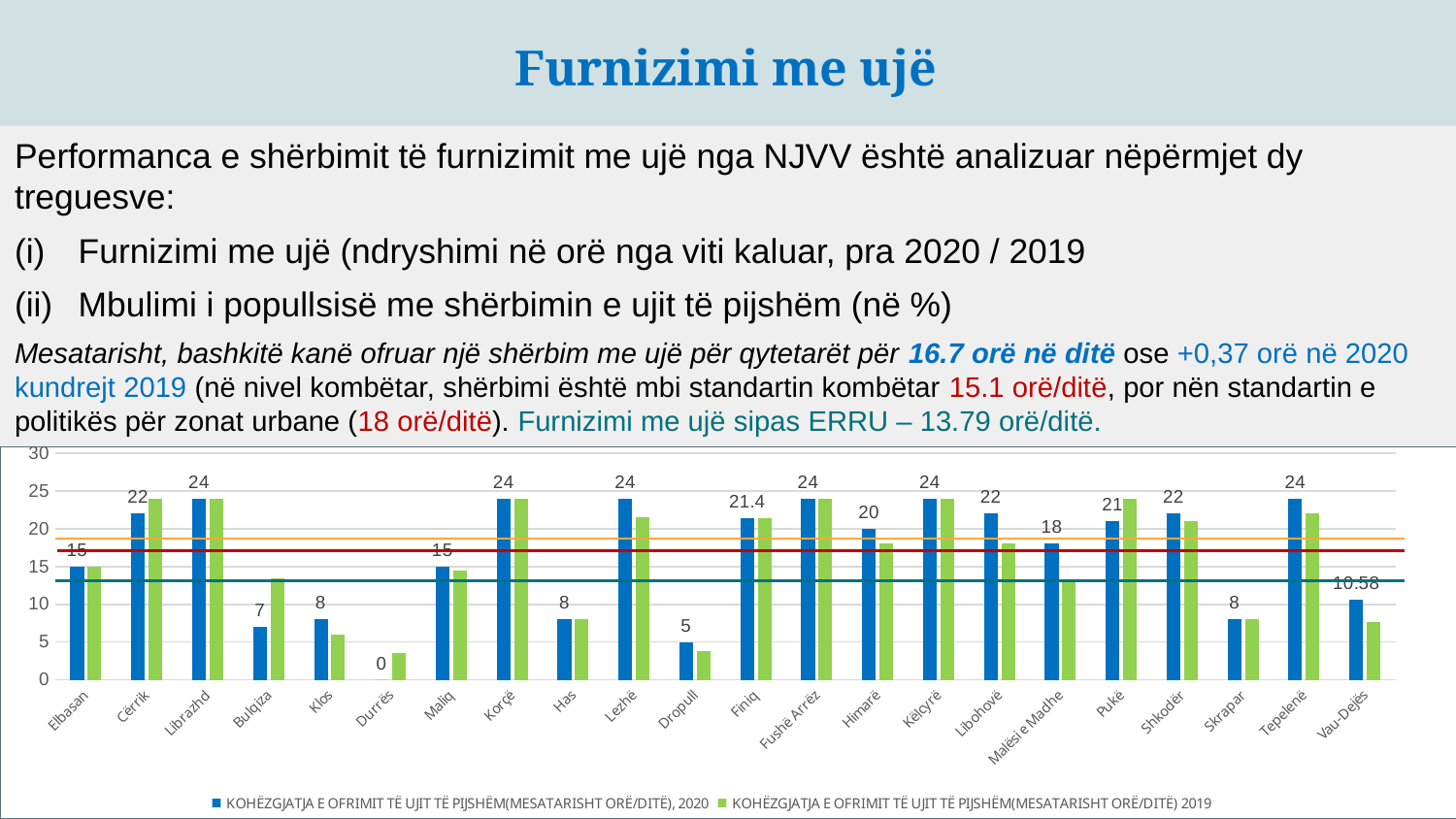
Is the 2019 value for Bulqiza greater or less than 10? greater How many municipalities are shown on the x axis? 22 What is the 2020 value for Finiq? 21.4 What is the difference between the 2020 values for Cërrik and Bulqiza? 15 What is the 2020 value for Vau-Dejës? 10.58 What is the highest 2020 value shown on the chart? 24 What is the 2020 value for Durrës? 0 Which municipality has the lowest 2020 value? Durrës What is the 2020 value for Malësi e Madhe? 18 Which has a larger 2020 value, Himarë or Dropull? Himarë What kind of chart is shown on the slide? Bar chart How many series does the legend list? 2